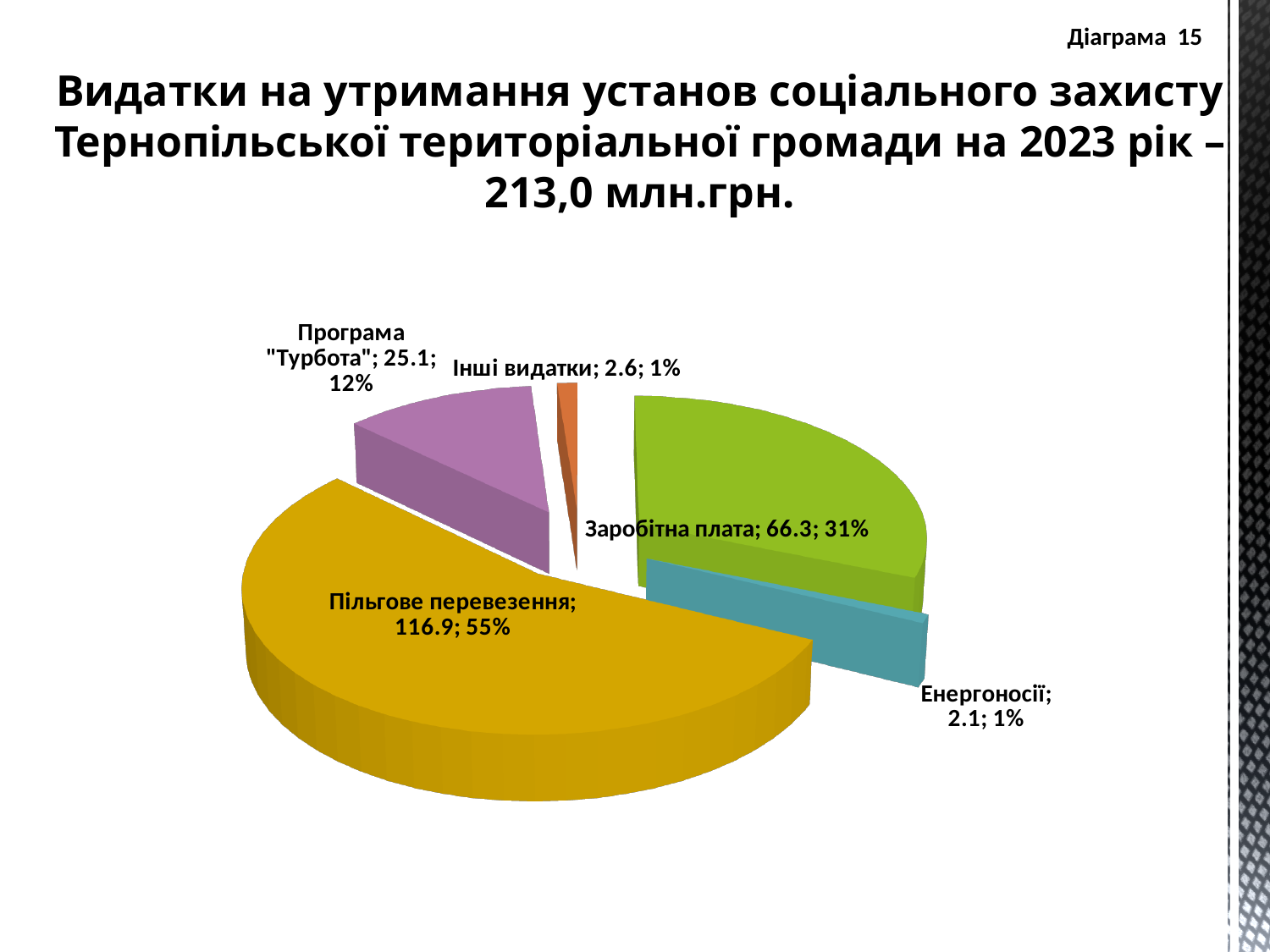
Which category has the smallest value? Енергоносії What is the value for Програма "Турбота"? 25.1 What is the value for Енергоносії? 2.1 What is the value for Пільгове перевезення? 116.9 Which category has the largest slice? Пільгове перевезення What share of the pie does Заробітна плата represent? 31% What type of chart is shown on the slide? pie chart Which is larger, Програма "Турбота" or Інші видатки? Програма "Турбота" What share of the pie does Пільгове перевезення represent? 55% What is the value for Заробітна плата? 66.3 How many slices does the pie chart have? 5 What is the difference between the values for Пільгове перевезення and Заробітна плата? 50.6